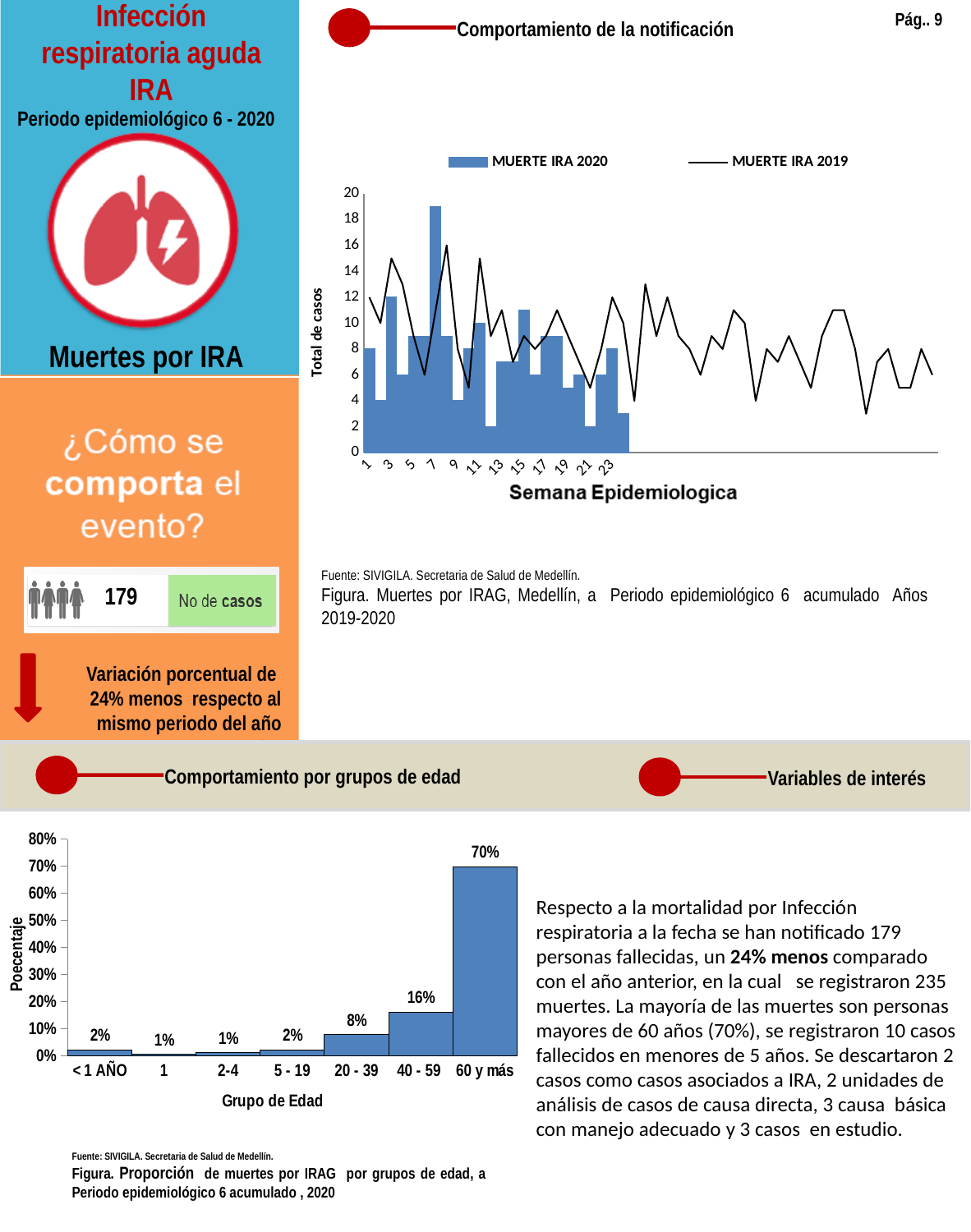
In the bottom chart (Proporción de muertes por IRAG por grupos de edad), what is the value for the '40 - 59' age group? 16% In the bottom chart (Proporción de muertes por IRAG por grupos de edad), which is larger, the value for '20 - 39' or the value for '5 - 19'? 20 - 39 In the bottom chart (Proporción de muertes por IRAG por grupos de edad), how many age groups are shown on the x axis? 7 In the top chart (Muertes por IRAG, Medellín), what is the label of the x axis? Semana Epidemiologica In the top chart (Muertes por IRAG, Medellín), is the MUERTE IRA 2020 value for week 7 greater or less than 16? greater In the top chart (Muertes por IRAG, Medellín), how many series does the legend list? 2 In the bottom chart (Proporción de muertes por IRAG por grupos de edad), what is the value for the '20 - 39' age group? 8% What kind of chart is the bottom chart (Proporción de muertes por IRAG por grupos de edad)? Bar chart In the bottom chart (Proporción de muertes por IRAG por grupos de edad), what is the value for the '60 y más' age group? 70% In the bottom chart (Proporción de muertes por IRAG por grupos de edad), which age group has the highest percentage? 60 y más In the bottom chart (Proporción de muertes por IRAG por grupos de edad), what is the difference between the '60 y más' and '40 - 59' values? 54% In the top chart (Muertes por IRAG, Medellín), which epidemiological week has the highest MUERTE IRA 2020 bar? 7